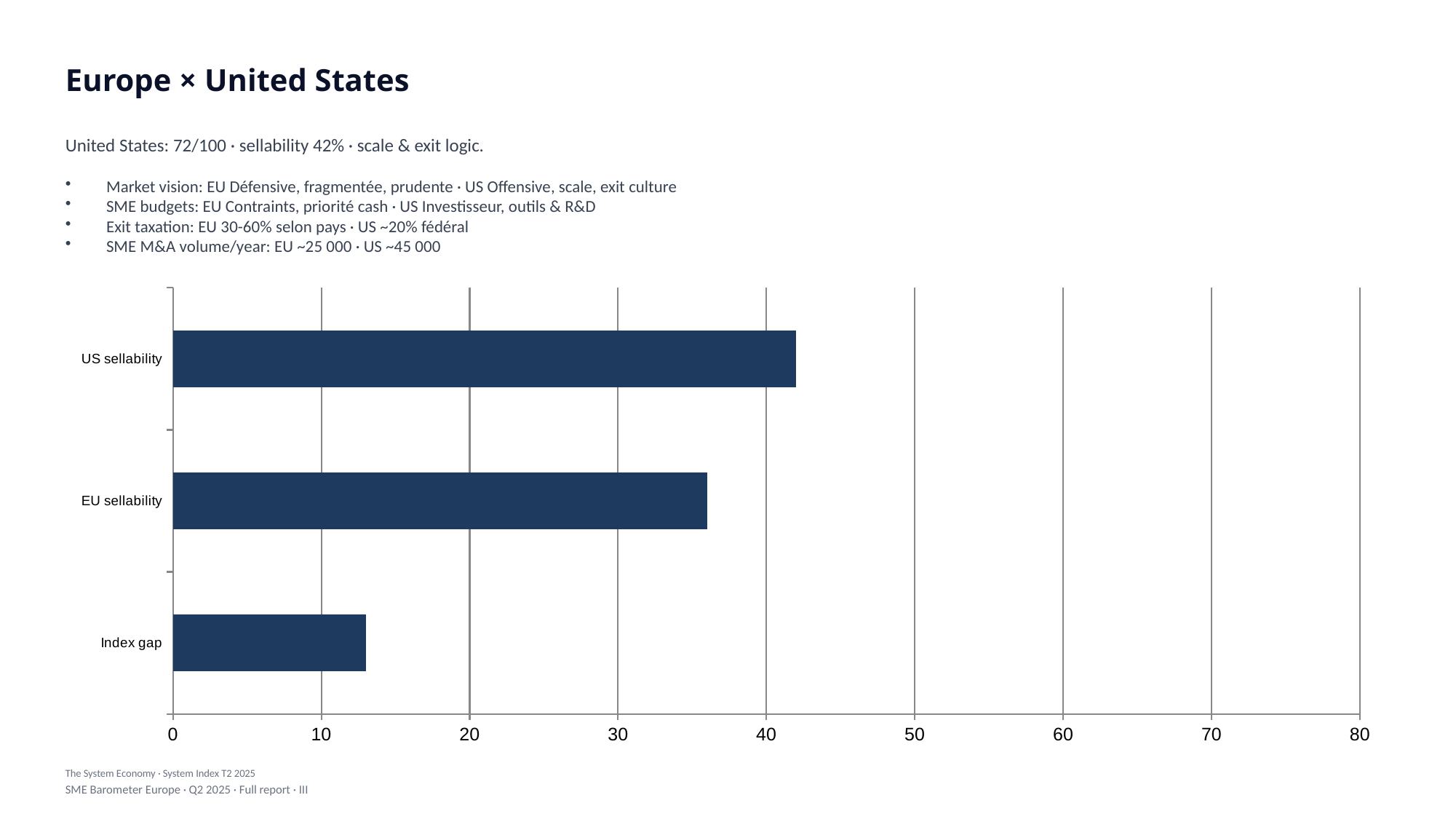
What is the maximum value shown on the horizontal axis of the chart? 80 Is the value for US sellability greater or less than 40? greater Which is larger, the value for US sellability or the value for EU sellability? US sellability How many categories are plotted in the chart? 3 What kind of chart is shown on the slide? bar chart Is the value for Index gap greater or less than 20? less Which category has the highest value in the chart? US sellability Is the value for EU sellability greater or less than 40? less Which category has the lowest value in the chart? Index gap Which is larger, the value for EU sellability or the value for Index gap? EU sellability